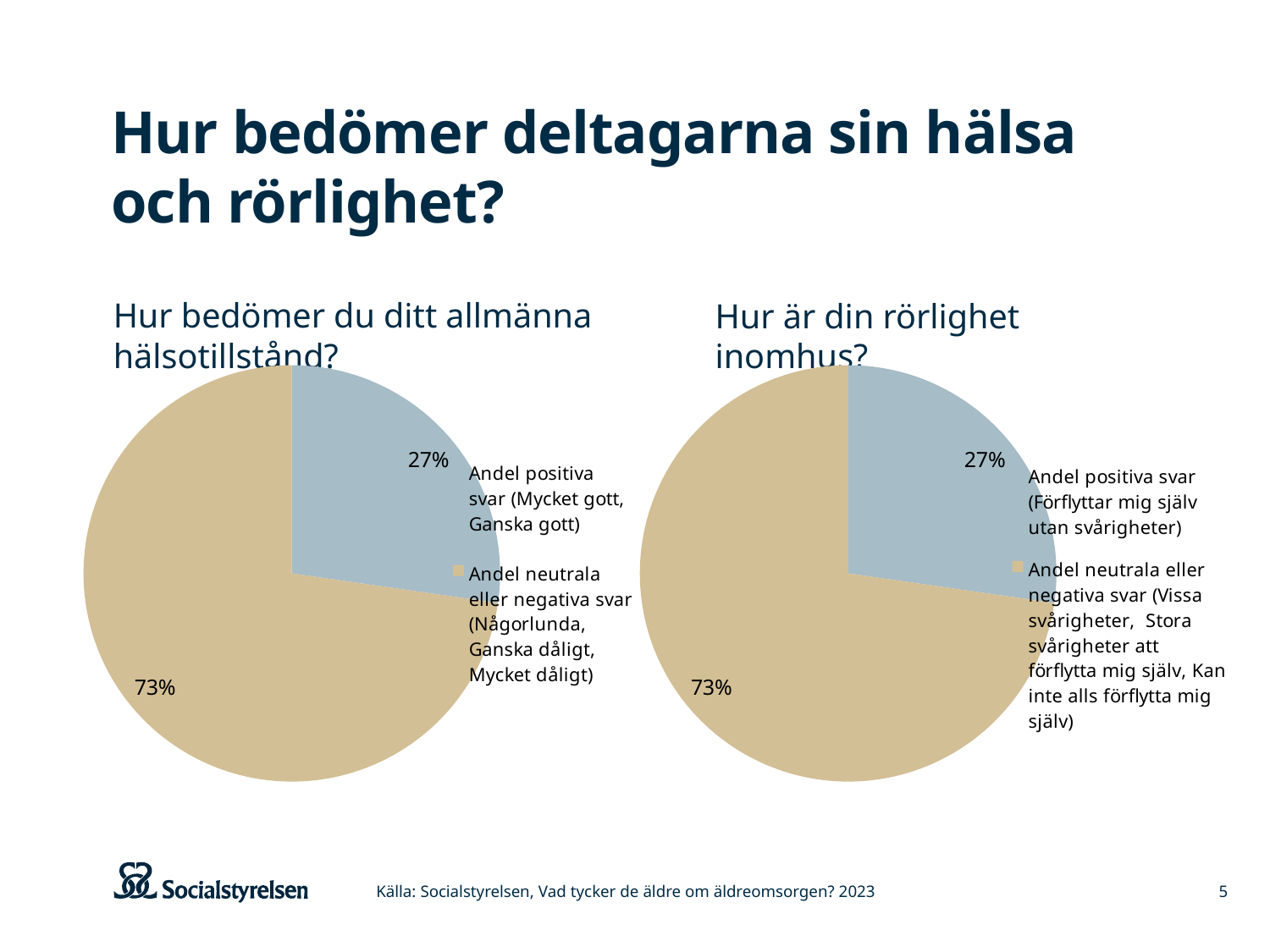
In the left chart 'Hur bedömer du ditt allmänna hälsotillstånd?', which slice is the largest? Andel neutrala eller negativa svar How many slices does the right chart 'Hur är din rörlighet inomhus?' have? 2 In the right chart 'Hur är din rörlighet inomhus?', what colour is the 'Andel positiva svar' slice? Light blue In the right chart 'Hur är din rörlighet inomhus?', what share is labelled for 'Andel neutrala eller negativa svar'? 73% What kind of chart is the left chart 'Hur bedömer du ditt allmänna hälsotillstånd?'? Pie chart In the right chart 'Hur är din rörlighet inomhus?', which slice is the smallest? Andel positiva svar In the left chart 'Hur bedömer du ditt allmänna hälsotillstånd?', what share is labelled for 'Andel neutrala eller negativa svar'? 73% In the left chart 'Hur bedömer du ditt allmänna hälsotillstånd?', what is the difference in percentage points between the two slices? 46 percentage points In the left chart 'Hur bedömer du ditt allmänna hälsotillstånd?', what share is labelled for 'Andel positiva svar'? 27% In the right chart 'Hur är din rörlighet inomhus?', which is larger: the positive-answer slice or the neutral/negative-answer slice? Andel neutrala eller negativa svar In the right chart 'Hur är din rörlighet inomhus?', what share is labelled for 'Andel positiva svar'? 27% How many entries does the legend of the left chart 'Hur bedömer du ditt allmänna hälsotillstånd?' list? 2